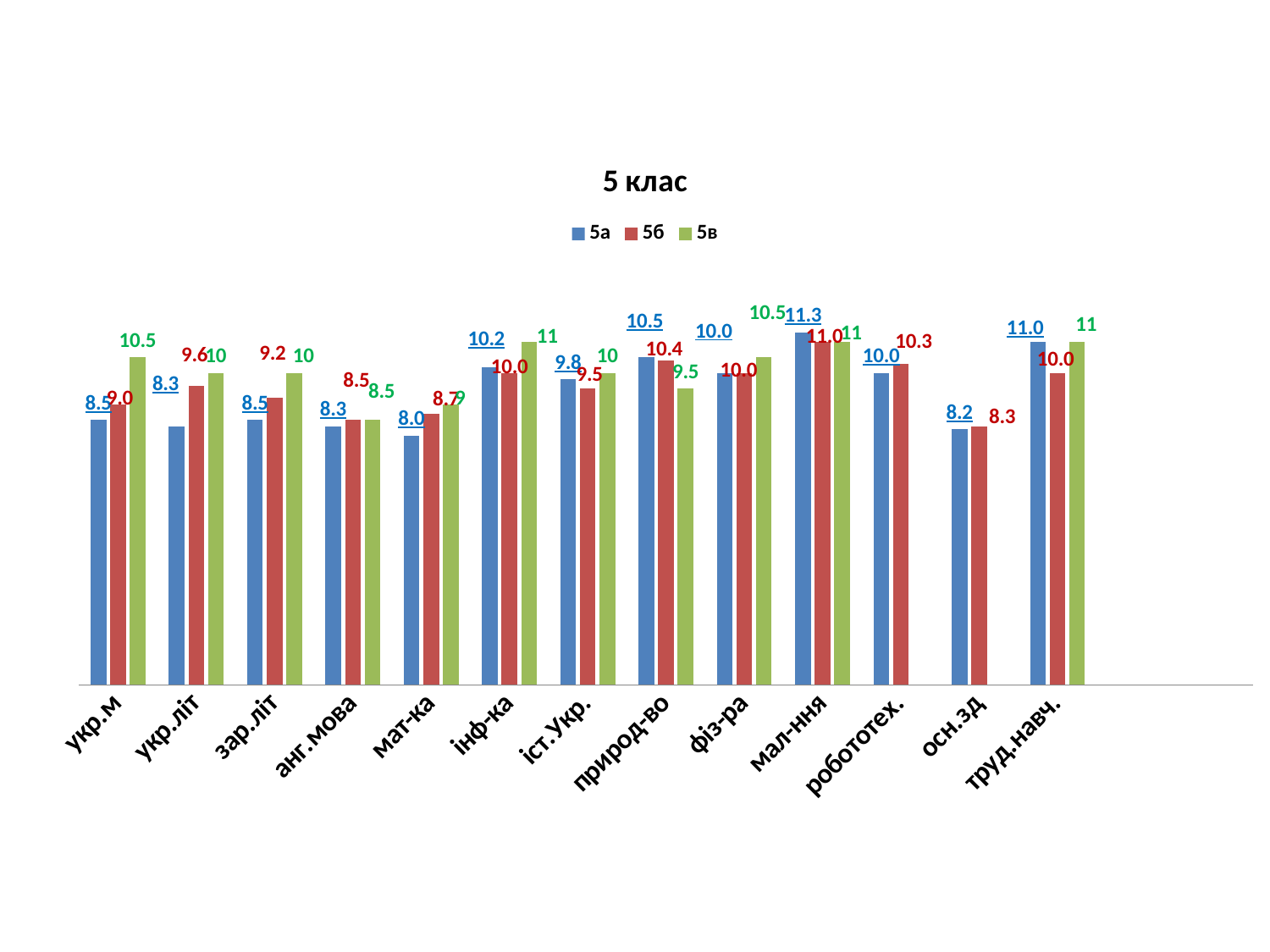
What kind of chart is shown on the slide? bar chart What is the value for 5в in укр.м? 10.5 Which subject has the highest value for 5а? мал-ння What is the value for 5а in труд.навч.? 11.0 How many series does the legend list? 3 What is the value for 5б in укр.літ? 9.6 What is the value for 5б in робототех.? 10.3 In природ-во, which is larger: the value for 5а or for 5в? 5а What is the title of the chart? 5 клас Which subject has the lowest value for 5а? мат-ка What is the difference between the 5в and 5а values in укр.м? 2.0 How many subject categories are shown on the x axis? 13